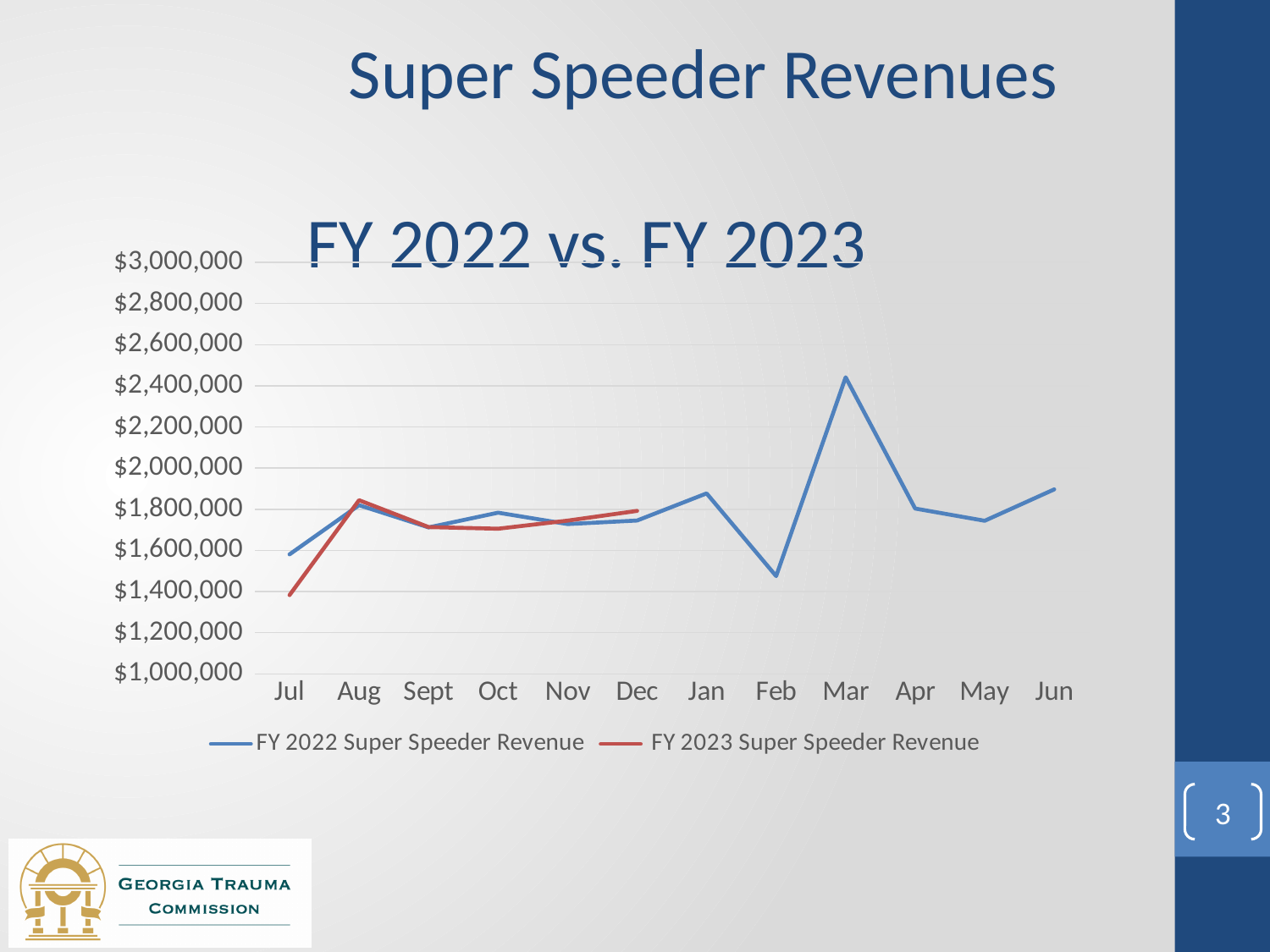
What colour is the line for FY 2023 Super Speeder Revenue? Red What kind of chart is shown on the slide? Line chart Is the FY 2022 Super Speeder Revenue for Feb greater or less than $1,600,000? less Is the FY 2022 Super Speeder Revenue for Mar greater or less than $2,200,000? greater In which month is the FY 2022 Super Speeder Revenue highest? Mar Is the FY 2023 Super Speeder Revenue for Jul greater or less than $1,600,000? less How many months are shown along the x axis? 12 How many series does the legend list? 2 In which month is the FY 2023 Super Speeder Revenue lowest? Jul Does the FY 2022 Super Speeder Revenue rise or fall from Jan to Feb? Fall In which month is the FY 2022 Super Speeder Revenue lowest? Feb In Jul, which series has the higher value, FY 2022 Super Speeder Revenue or FY 2023 Super Speeder Revenue? FY 2022 Super Speeder Revenue